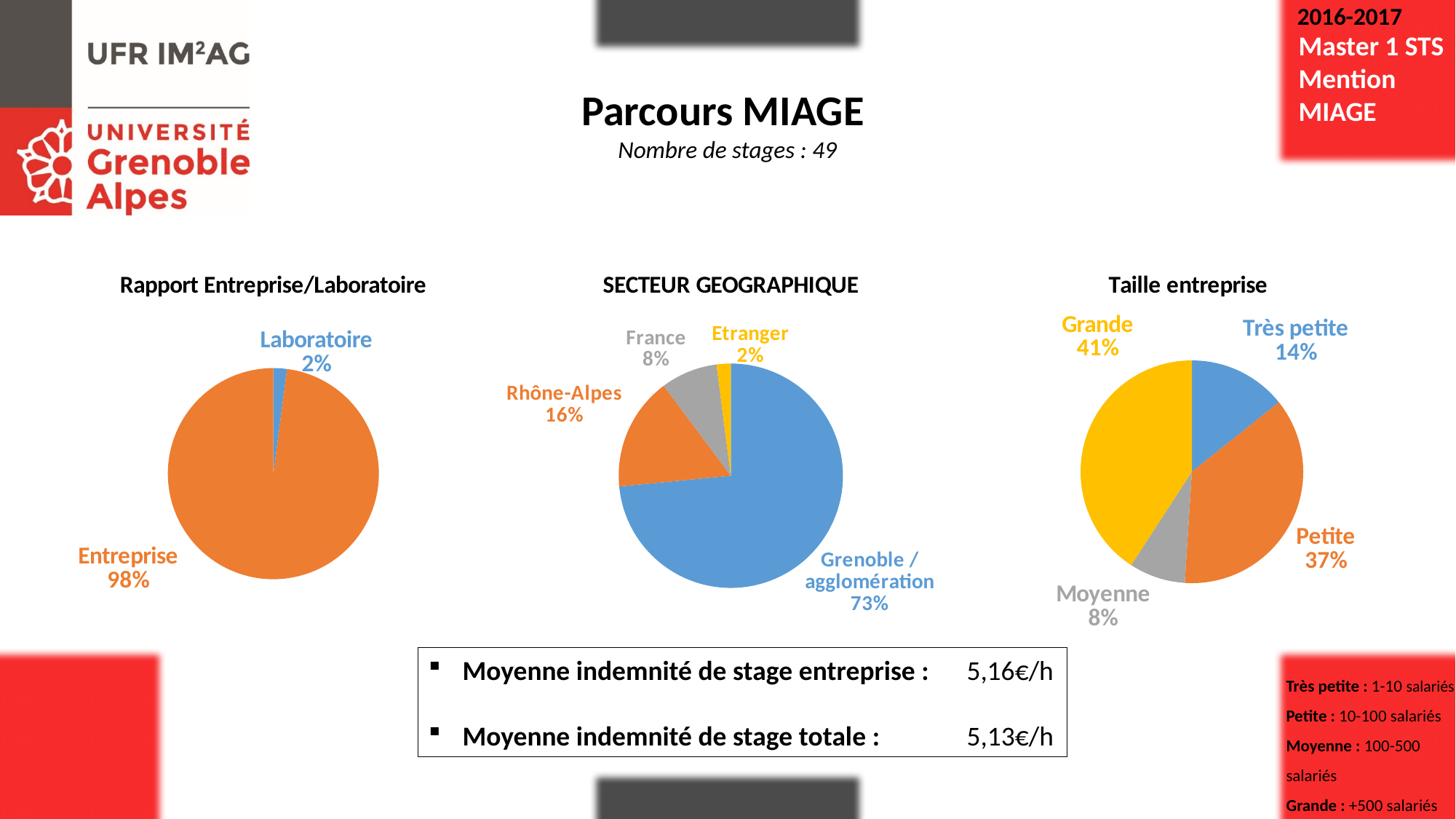
In the 'SECTEUR GEOGRAPHIQUE' chart, how many categories are shown? 4 In the 'Taille entreprise' chart, what colour is the Grande slice? Yellow In the 'Taille entreprise' chart, which is larger, Très petite or Moyenne? Très petite In the 'Taille entreprise' chart, what is the value for Petite? 37% In the 'Taille entreprise' chart, which category has the largest share? Grande In the 'Rapport Entreprise/Laboratoire' chart, what share of the pie is Entreprise? 98% In the 'SECTEUR GEOGRAPHIQUE' chart, what is the difference between Grenoble / agglomération and Rhône-Alpes? 57% In the 'SECTEUR GEOGRAPHIQUE' chart, what is the value for Rhône-Alpes? 16% In the 'SECTEUR GEOGRAPHIQUE' chart, which category has the largest share? Grenoble / agglomération In the 'SECTEUR GEOGRAPHIQUE' chart, which category has the smallest share? Etranger What kind of chart is the 'SECTEUR GEOGRAPHIQUE' chart? Pie chart In the 'Rapport Entreprise/Laboratoire' chart, what is the value for Laboratoire? 2%